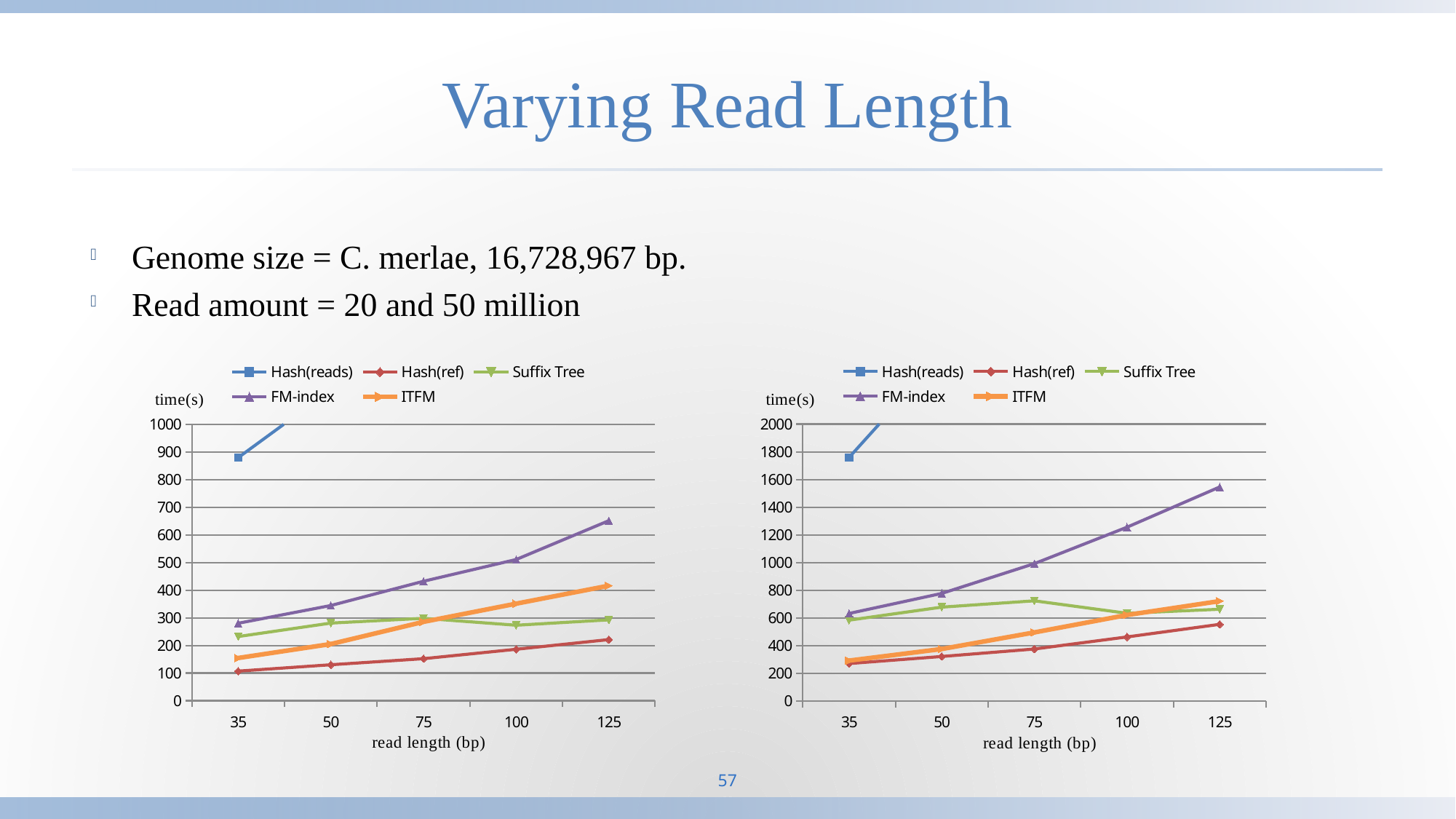
How many read length values are shown on the x axis of the left chart? 5 In the right chart, is the FM-index value at read length 125 greater or less than 1400? greater In the left chart, does the FM-index time rise or fall as read length increases? rise In the left chart, which is larger at read length 125: FM-index or ITFM? FM-index In the right chart, which series has the lowest value at read length 125? Hash(ref) In the left chart, is the FM-index value at read length 125 greater or less than 600? greater In the right chart, is the Suffix Tree value at read length 75 greater or less than 600? greater What is the x-axis label of the right chart? read length (bp) What kind of chart is the left chart on the slide? line chart How many series does the legend of the right chart list? 5 In the right chart, does the Hash(ref) time rise or fall as read length increases? rise